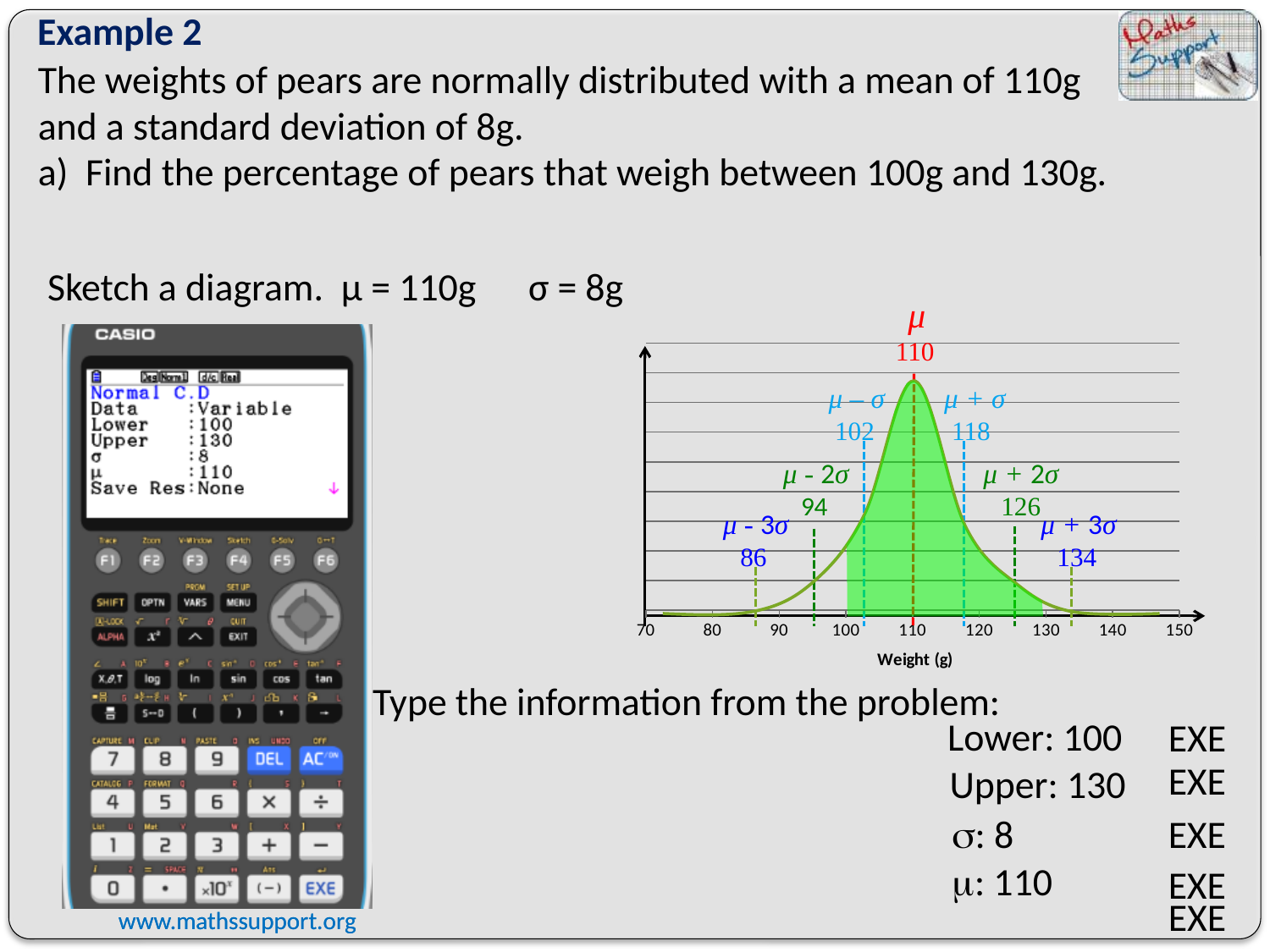
Between which two weights on the x axis is the area under the curve shaded green? 100 and 130 What weight is labelled at μ + 2σ on the chart? 126 What weight is labelled at μ - 3σ on the chart? 86 What weight is labelled at μ – σ on the chart? 102 What weight is labelled at μ + σ on the chart? 118 What is the difference between the weights labelled at μ + σ and μ – σ on the chart? 16 What is the difference between the weights labelled at μ + 3σ and μ - 3σ on the chart? 48 What kind of chart is shown on the right of the slide? line chart (normal distribution curve) At what weight is the mean μ marked on the chart? 110 At which weight does the curve reach its highest point? 110 What is the title of the horizontal axis of the chart? Weight (g) Does the curve rise or fall as the weight increases from 110 to 150? fall